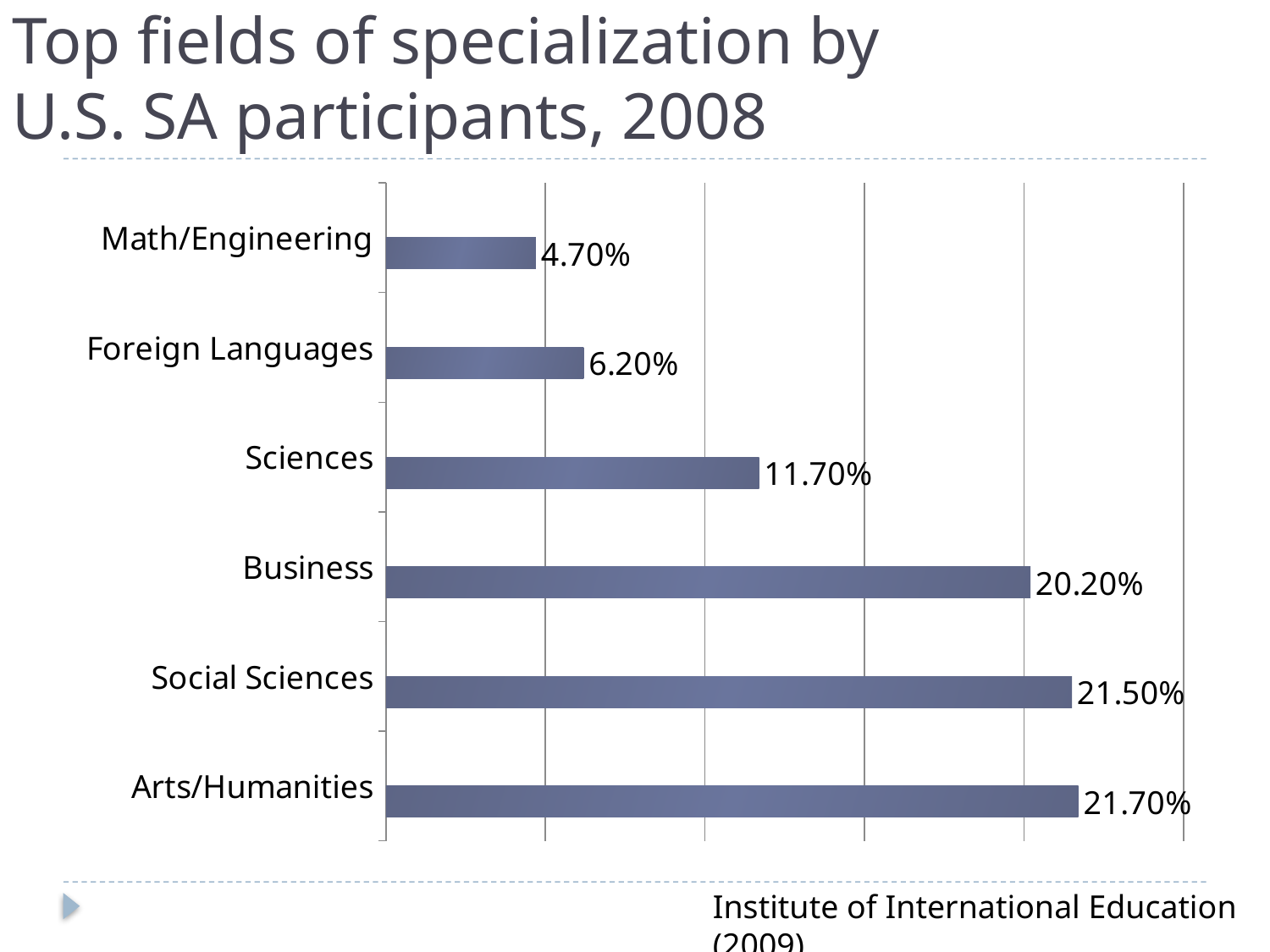
Which is larger, the value for Foreign Languages or the value for Math/Engineering? Foreign Languages What is the value for Sciences? 11.70% What is the title of the slide? Top fields of specialization by U.S. SA participants, 2008 What is the difference between the values for Sciences and Foreign Languages? 5.50% Which field has the lowest value? Math/Engineering What is the difference between the values for Social Sciences and Business? 1.30% What kind of chart is shown on the slide? Bar chart Which field has the highest value? Arts/Humanities How many fields are shown in the chart? 6 Which is larger, the value for Business or the value for Sciences? Business What is the value for Math/Engineering? 4.70% What is the value for Business? 20.20%